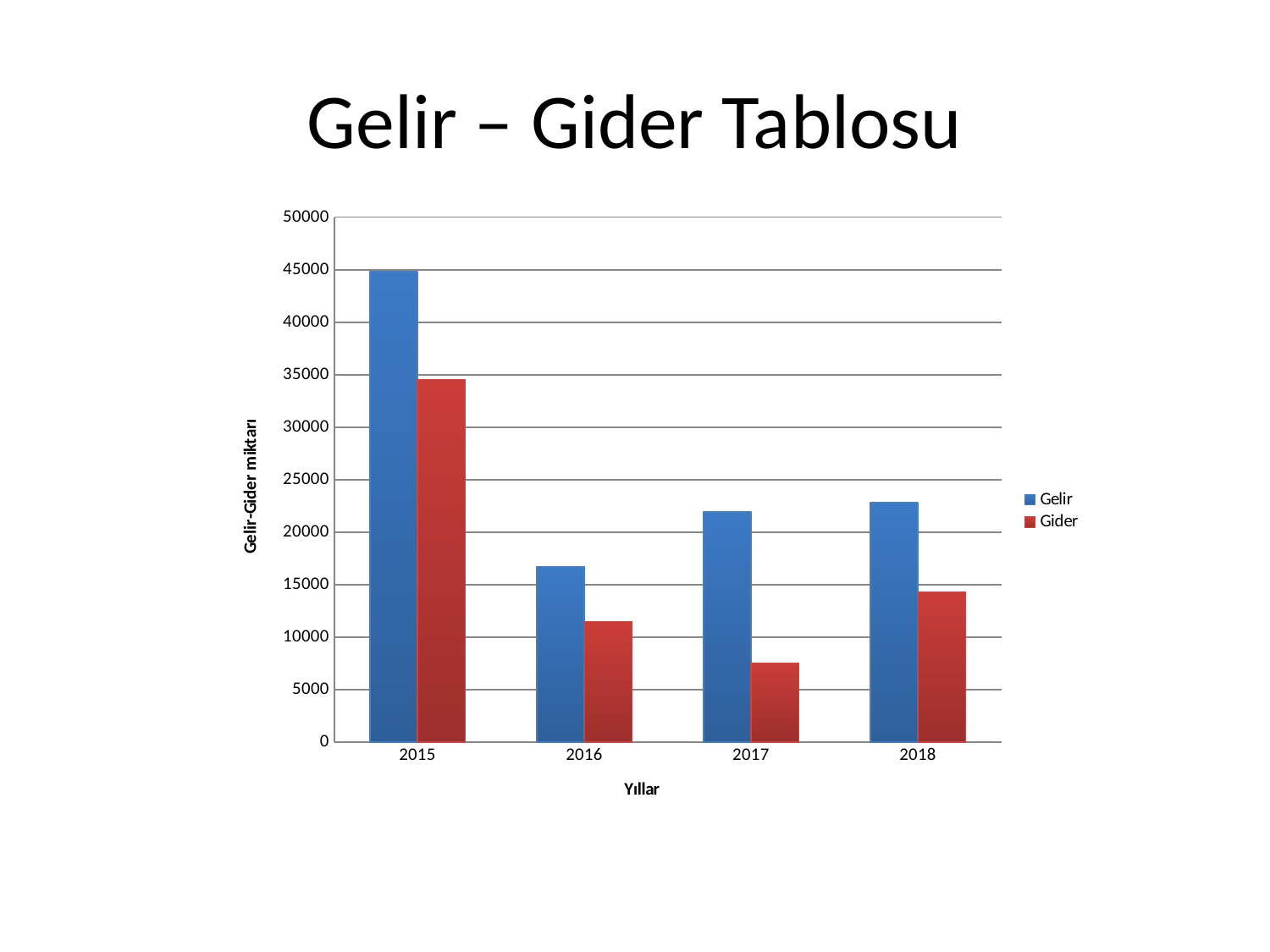
Is the Gider value for 2017 greater or less than 10000? less Is the Gelir value for 2017 greater or less than 20000? greater In which year is Gelir highest? 2015 In which year is Gider lowest? 2017 What is the title of the x axis? Yıllar How many series does the legend list? 2 Does Gelir rise or fall from 2016 to 2018? rise In which year is Gelir lowest? 2016 In 2015, which is larger, Gelir or Gider? Gelir Is the Gider value for 2015 greater or less than 30000? greater What kind of chart is shown on the slide? bar chart How many years are shown on the x axis? 4